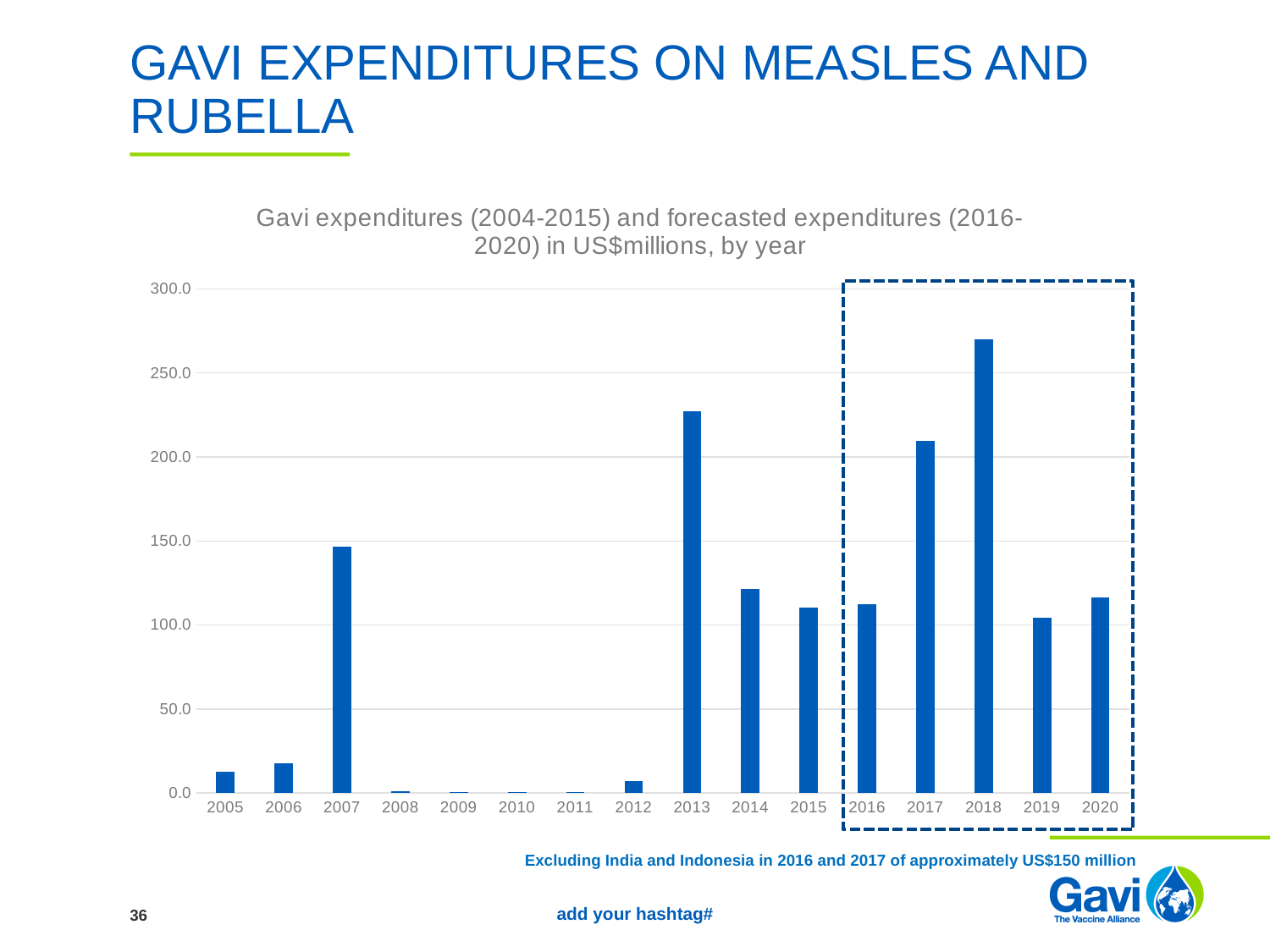
Which year has the highest expenditure in the chart? 2018 Is the value for 2013 greater or less than 200.0? greater Is the value for 2012 greater or less than 50.0? less Is the value for 2007 greater or less than 150.0? less In what unit are the expenditures in the chart expressed, according to the chart title? US$millions Which year has the larger expenditure, 2013 or 2018? 2018 How many years are shown on the x axis of the chart? 16 What kind of chart is shown on the slide? Bar chart Which year has the larger expenditure, 2007 or 2014? 2007 Do the values rise or fall from 2016 to 2018? rise